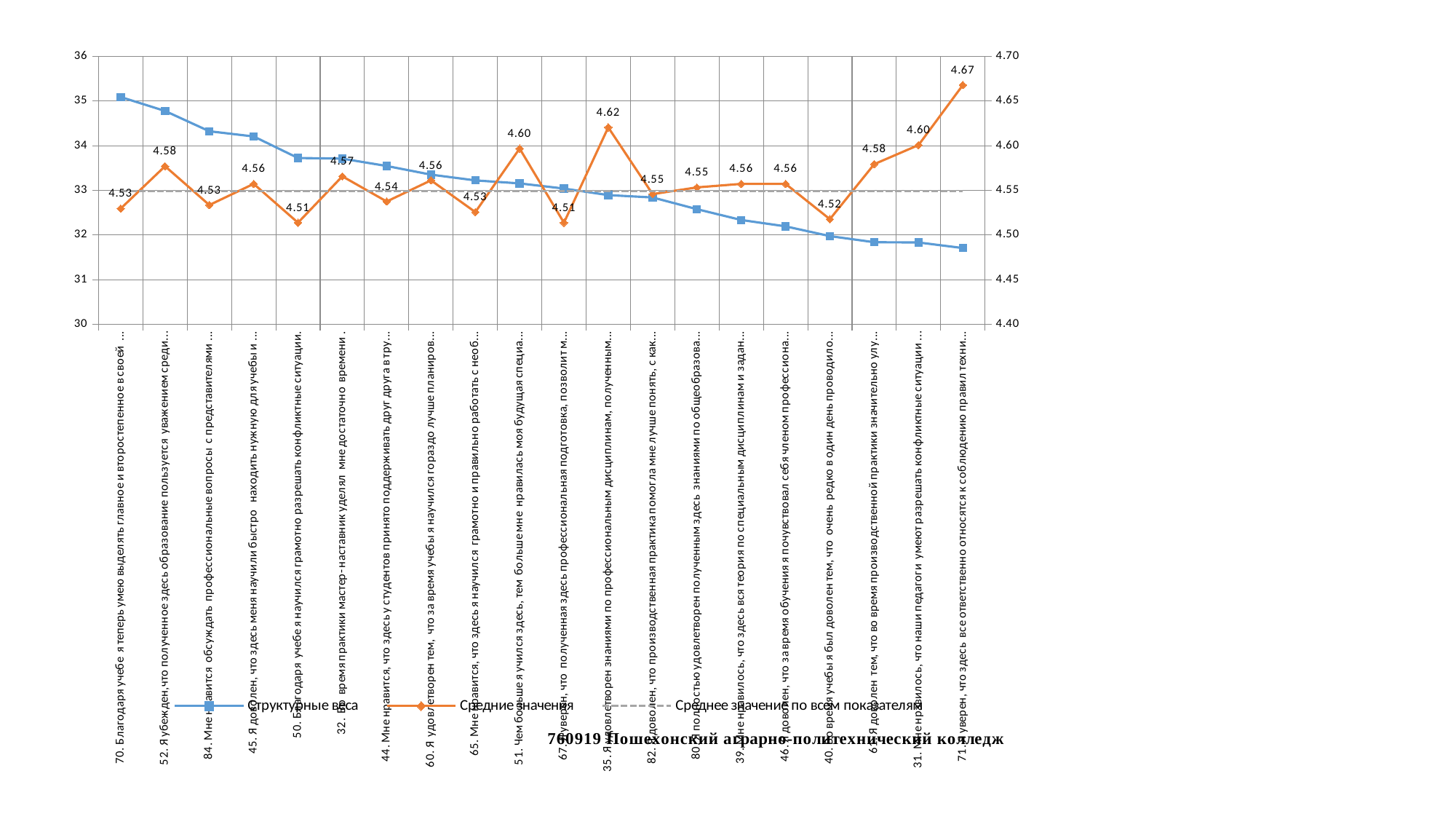
What is the name of the dashed series in the legend? Среднее значение по всем показателям Is the 'Структурные веса' value for item 71 greater or less than 32? less How many categories (survey items) are plotted along the x axis? 20 Do the 'Структурные веса' values rise or fall along the x axis from left to right? fall What type of chart is shown on the slide? line chart Which item has the highest 'Средние значения' value? 71. Я уверен, что здесь все ответственно относятся к соблюдению правил техни... Which has the larger 'Средние значения' value: item 51 or item 44? item 51 What is the value of 'Средние значения' for item 71 ('Я уверен, что здесь все ответственно относятся к соблюдению правил техни...')? 4.67 What is the difference between the 'Средние значения' values for item 71 and item 35? 0.05 What is the value of 'Средние значения' for item 50 ('Благодаря учебе я научился грамотно разрешать конфликтные ситуации')? 4.51 How many series does the legend list? 3 What is the value of 'Средние значения' for item 35 ('Я удовлетворен знаниями по профессиональным дисциплинам, полученным...')? 4.62